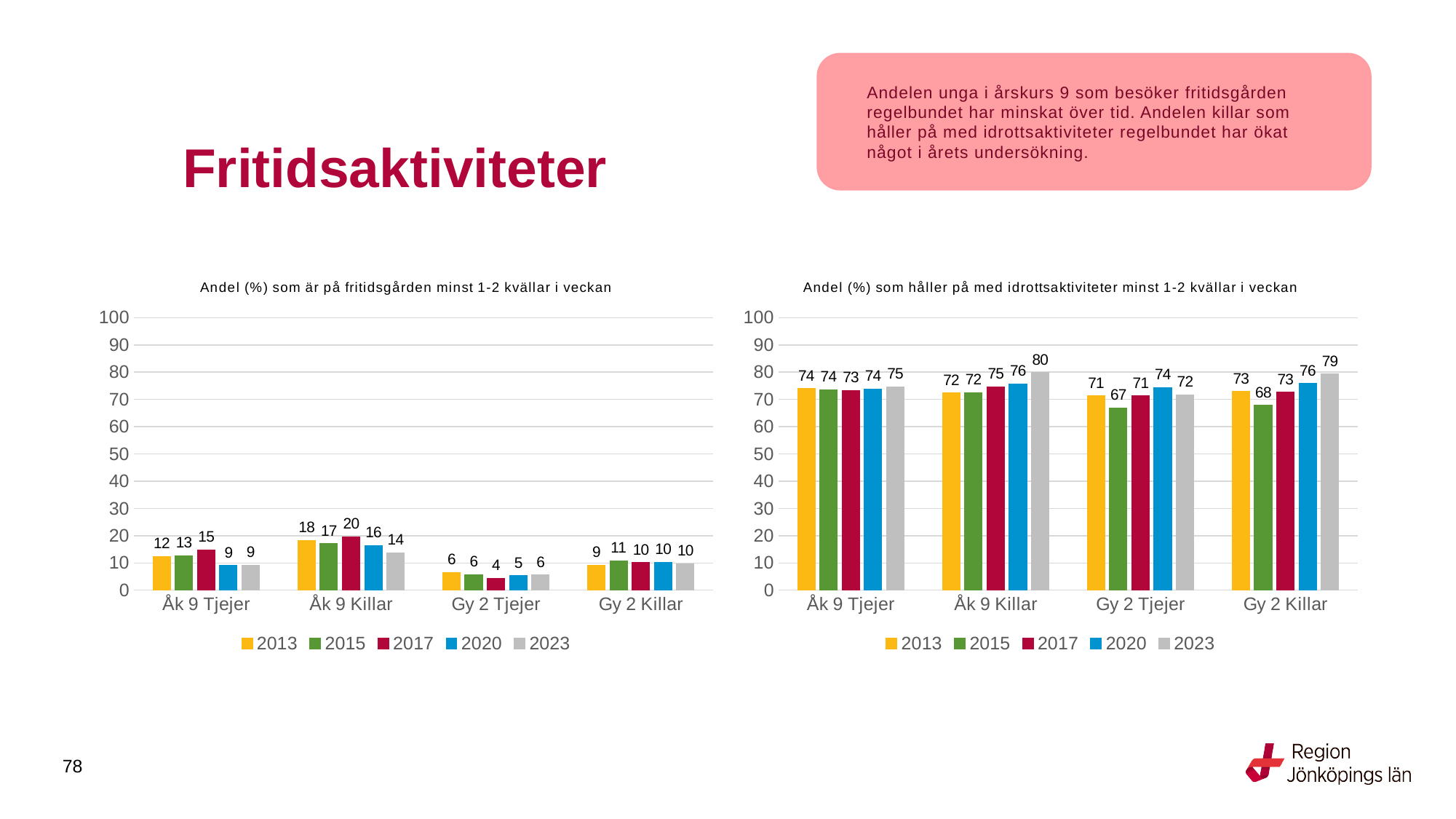
In the right chart (Andel (%) som håller på med idrottsaktiviteter minst 1-2 kvällar i veckan), which is larger for Gy 2 Tjejer: the 2020 value or the 2015 value? 2020 In the left chart (Andel (%) som är på fritidsgården minst 1-2 kvällar i veckan), is the value for Åk 9 Killar in 2017 greater or less than 10? greater In the right chart (Andel (%) som håller på med idrottsaktiviteter minst 1-2 kvällar i veckan), what is the value for Åk 9 Killar in 2023? 80 In the left chart (Andel (%) som är på fritidsgården minst 1-2 kvällar i veckan), which category has the highest value for 2013? Åk 9 Killar In the right chart (Andel (%) som håller på med idrottsaktiviteter minst 1-2 kvällar i veckan), which category has the lowest value for 2015? Gy 2 Tjejer How many series does the legend of the right chart (Andel (%) som håller på med idrottsaktiviteter minst 1-2 kvällar i veckan) list? 5 In the left chart (Andel (%) som är på fritidsgården minst 1-2 kvällar i veckan), what is the value for Gy 2 Tjejer in 2017? 4 In the right chart (Andel (%) som håller på med idrottsaktiviteter minst 1-2 kvällar i veckan), what is the difference between the 2023 and 2013 values for Gy 2 Killar? 6 In the left chart (Andel (%) som är på fritidsgården minst 1-2 kvällar i veckan), what is the difference between the 2013 and 2023 values for Åk 9 Killar? 4 What kind of chart is the right chart (Andel (%) som håller på med idrottsaktiviteter minst 1-2 kvällar i veckan)? Bar chart How many categories are shown on the x axis of the left chart (Andel (%) som är på fritidsgården minst 1-2 kvällar i veckan)? 4 In the left chart (Andel (%) som är på fritidsgården minst 1-2 kvällar i veckan), what is the value for Åk 9 Killar in 2017? 20